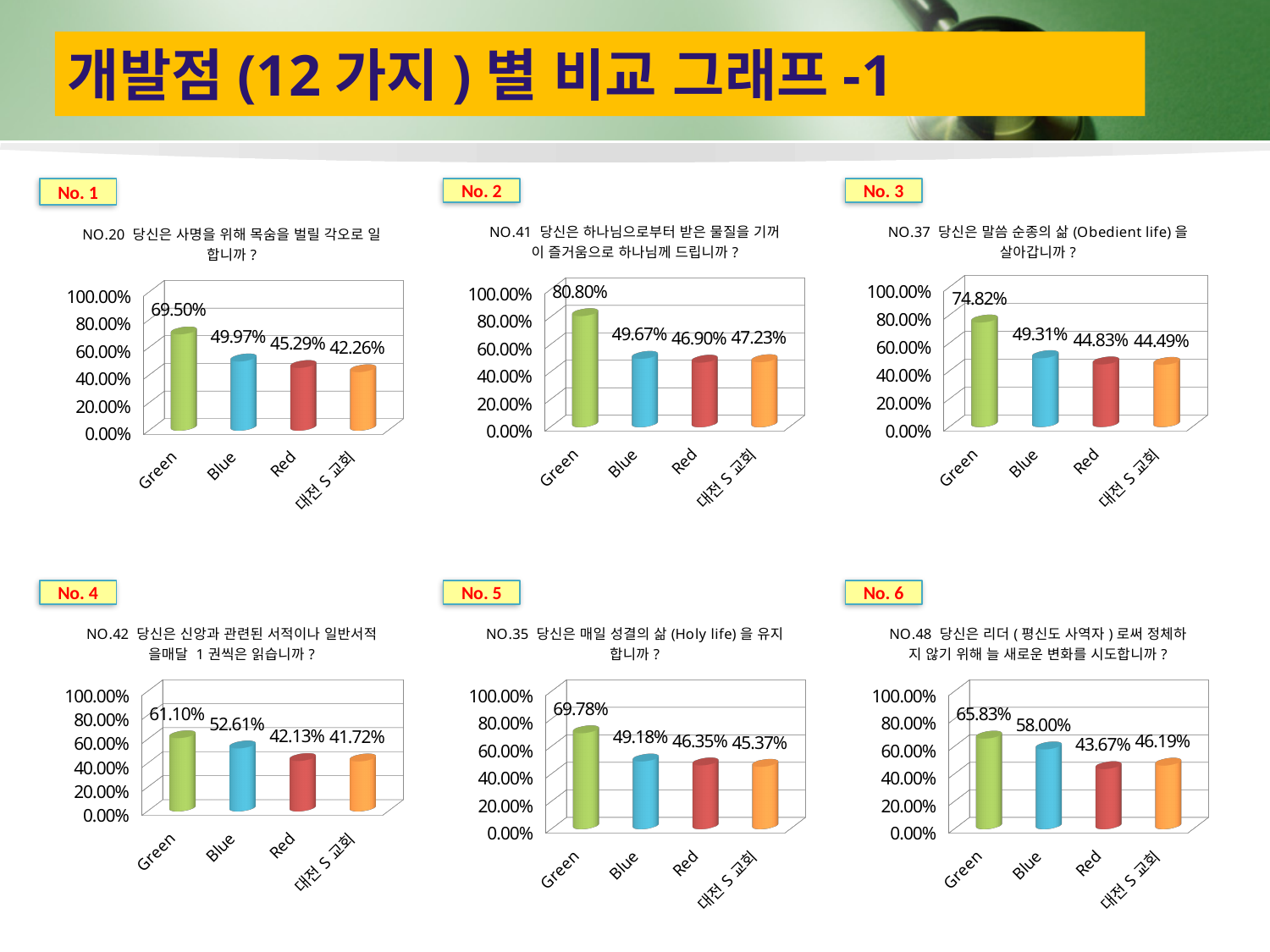
In the No. 2 chart, what is the value for 대전 S 교회? 47.23% In the No. 1 chart, what is the difference between the Green and Blue values? 19.53% In the No. 3 chart, which category has the highest value? Green In the No. 4 chart, what is the value for Blue? 52.61% In the No. 6 chart, what is the value for Red? 43.67% In the No. 3 chart, is the value for Green greater or less than 60.00%? greater In the No. 1 chart, which category has the lowest value? 대전 S 교회 In the No. 1 chart, do the values rise or fall from Green to 대전 S 교회 along the x axis? fall How many categories are shown in the No. 5 chart? 4 What kind of chart is the No. 2 chart? bar chart In the No. 6 chart, which is larger, the value for Red or the value for 대전 S 교회? 대전 S 교회 In the No. 1 chart, what is the value for Green? 69.50%